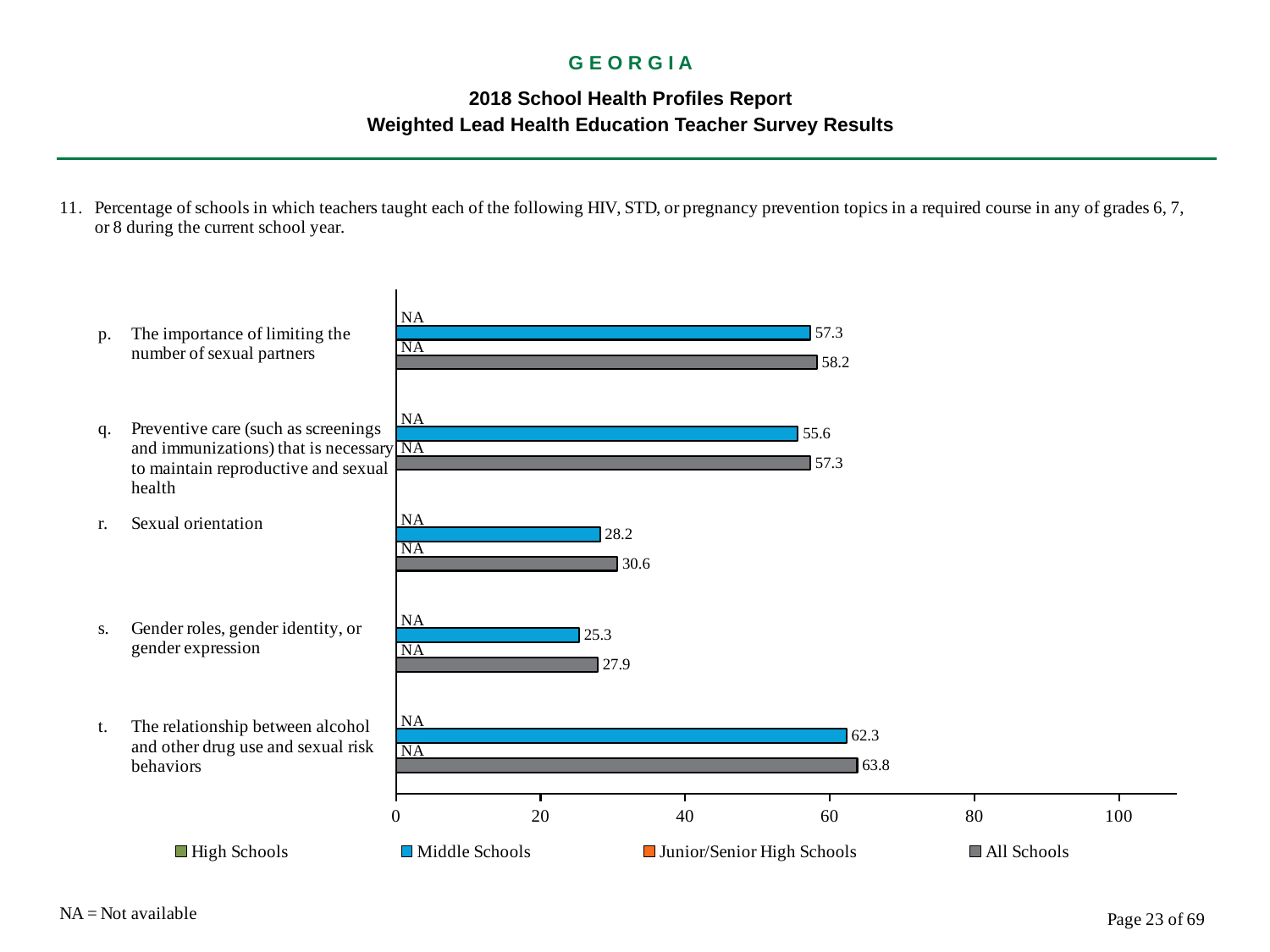
Which topic has the lowest Middle Schools value? Gender roles, gender identity, or gender expression How many topics are listed on the chart? 5 Which topic has the highest All Schools value? The relationship between alcohol and other drug use and sexual risk behaviors What is the All Schools value for 'The relationship between alcohol and other drug use and sexual risk behaviors'? 63.8 What is the difference between the All Schools and Middle Schools values for 'Preventive care (such as screenings and immunizations) that is necessary to maintain reproductive and sexual health'? 1.7 Which is larger for 'Sexual orientation': the Middle Schools value or the All Schools value? All Schools How many series does the legend list? 4 What kind of chart is shown on the slide? Bar chart What is the Middle Schools value for 'Gender roles, gender identity, or gender expression'? 25.3 What value is shown for High Schools for 'Sexual orientation'? NA What is the All Schools value for 'Sexual orientation'? 30.6 What is the Middle Schools value for 'The importance of limiting the number of sexual partners'? 57.3